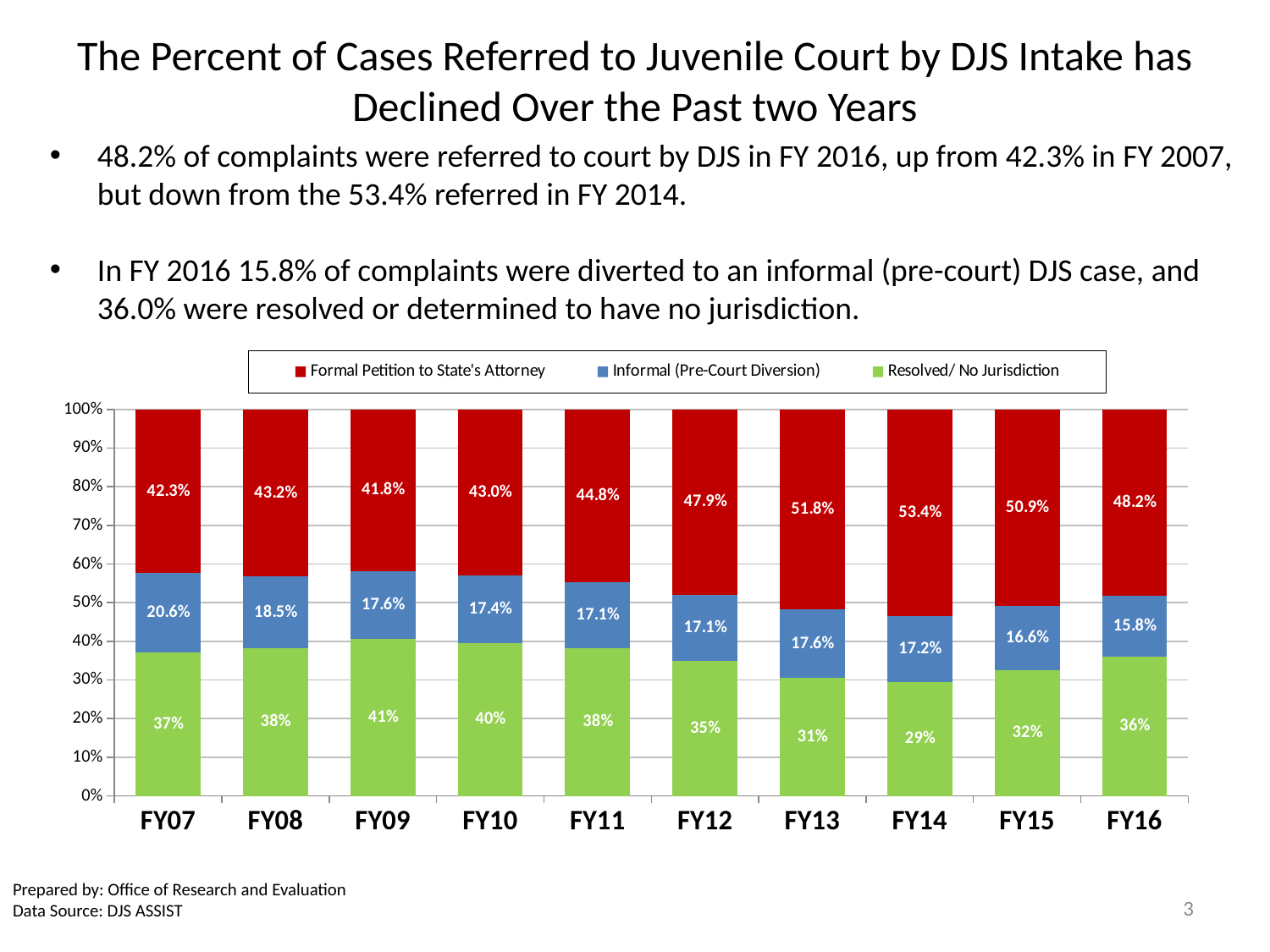
What is the value for Informal (Pre-Court Diversion) in FY07? 20.6% Does the Informal (Pre-Court Diversion) share rise or fall from FY07 to FY16? Fall Which colour represents Resolved/ No Jurisdiction in the chart? Green In which fiscal year is the Formal Petition to State's Attorney share highest? FY14 What is the value for Formal Petition to State's Attorney in FY16? 48.2% What is the value for Resolved/ No Jurisdiction in FY14? 29% What kind of chart is shown on the slide? Stacked bar chart How many fiscal years are shown on the x axis? 10 In which fiscal year is the Resolved/ No Jurisdiction share lowest? FY14 What is the difference between the Formal Petition to State's Attorney share in FY14 and in FY16? 5.2% Which is larger, the Informal (Pre-Court Diversion) share in FY09 or in FY16? FY09 How many series does the legend list? 3